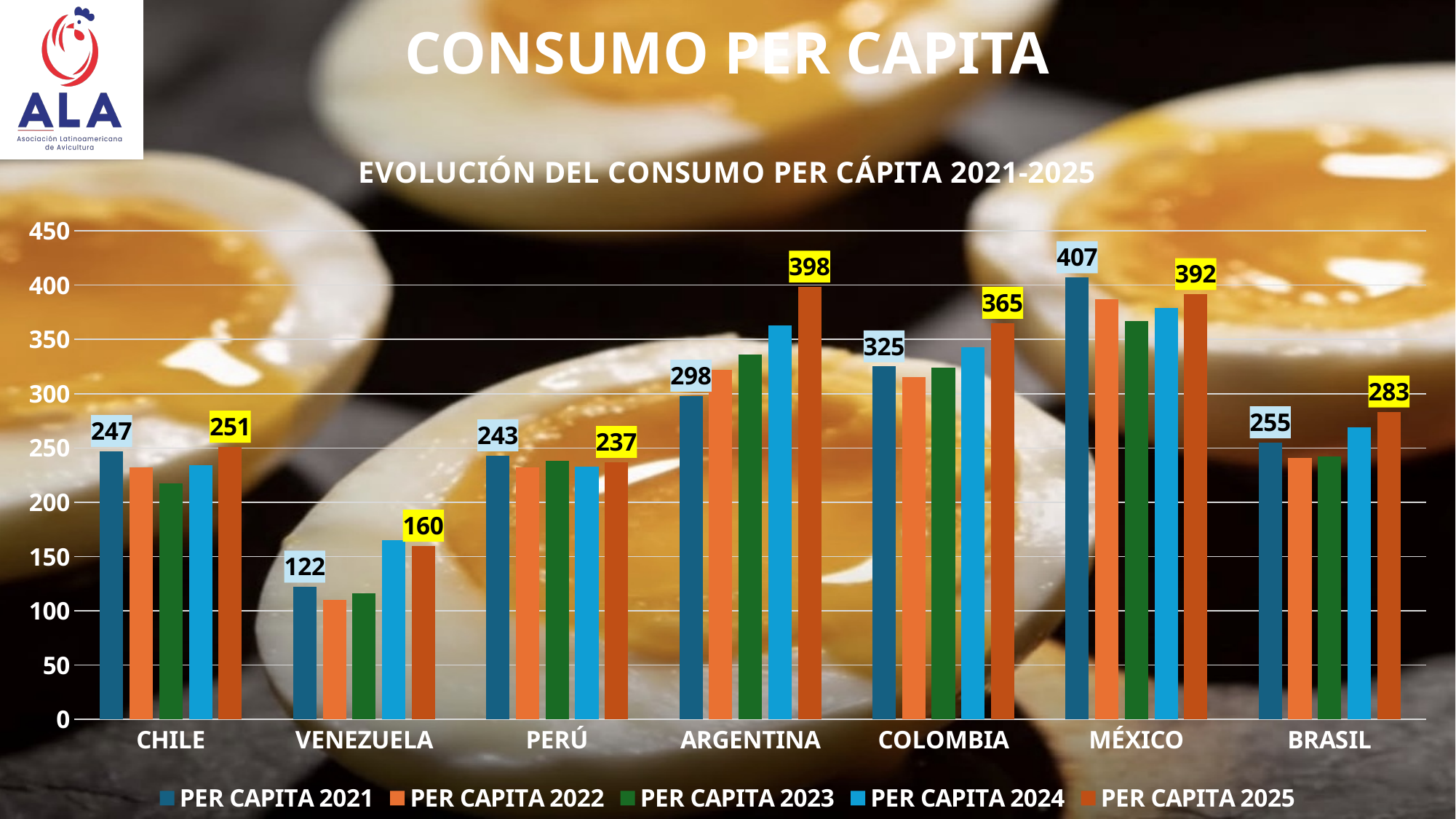
What is the PER CAPITA 2021 value for Argentina? 298 Is the PER CAPITA 2023 value for Chile greater or less than 250? less How many series does the legend list? 5 What is the difference between the PER CAPITA 2025 and PER CAPITA 2021 values for Argentina? 100 What is the title of the chart? EVOLUCIÓN DEL CONSUMO PER CÁPITA 2021-2025 How many countries are shown on the x axis? 7 What is the PER CAPITA 2025 value for Venezuela? 160 Which is larger for Perú: the PER CAPITA 2021 value or the PER CAPITA 2025 value? PER CAPITA 2021 Which country has the highest PER CAPITA 2025 value? Argentina What kind of chart is shown on the slide? bar chart What is the PER CAPITA 2021 value for México? 407 Which country has the lowest PER CAPITA 2021 value? Venezuela